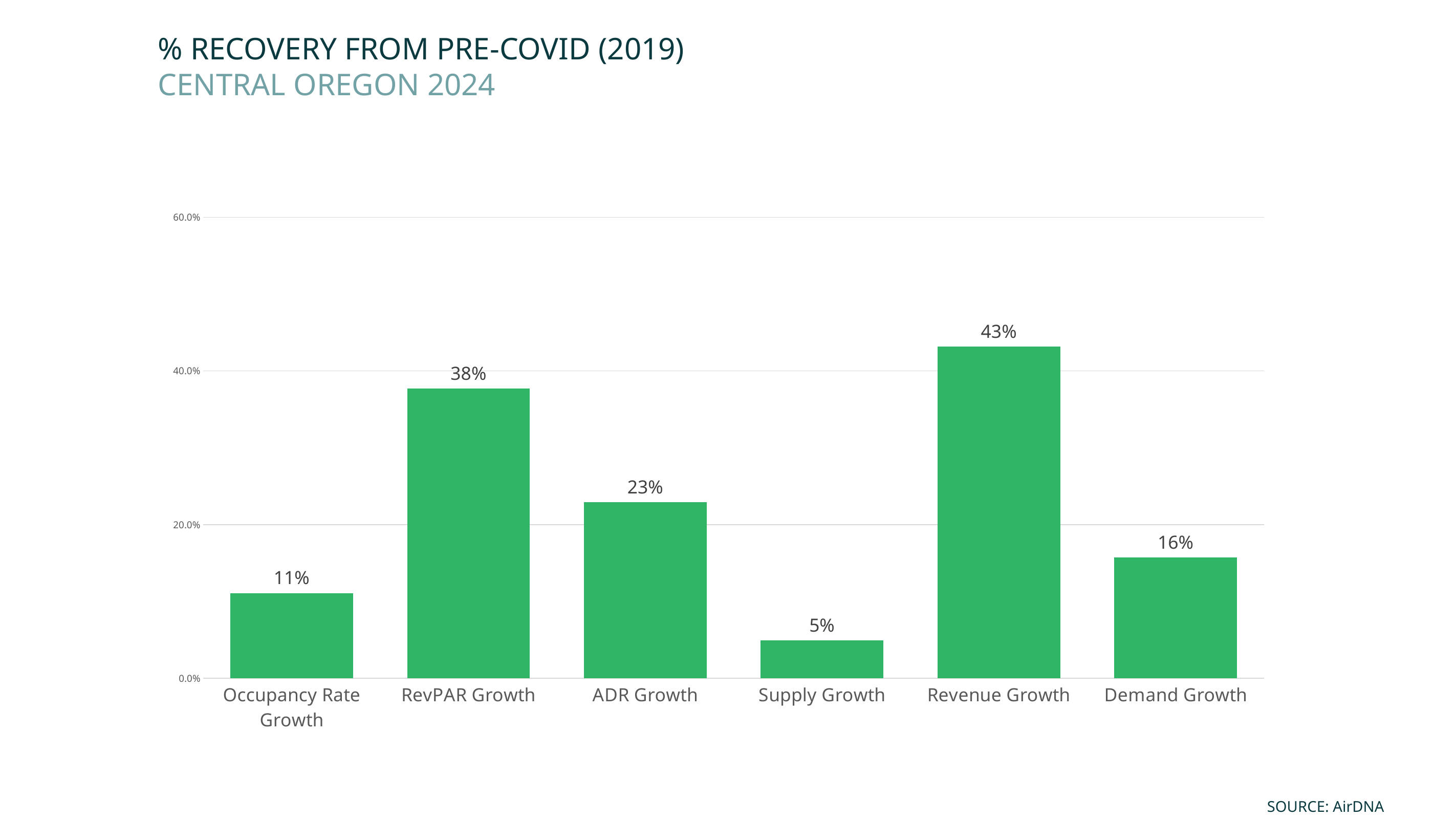
What is the value for Supply Growth? 5% What is the difference between ADR Growth and Occupancy Rate Growth? 12% Is the value for Revenue Growth greater or less than 40.0%? greater What is the value for RevPAR Growth? 38% What is the source cited for the chart? AirDNA Which category has the highest value? Revenue Growth Which is larger, ADR Growth or Demand Growth? ADR Growth What kind of chart is shown on the slide? Bar chart What is the difference between Revenue Growth and RevPAR Growth? 5% Which category has the lowest value? Supply Growth How many categories are shown on the chart? 6 What is the value for Demand Growth? 16%